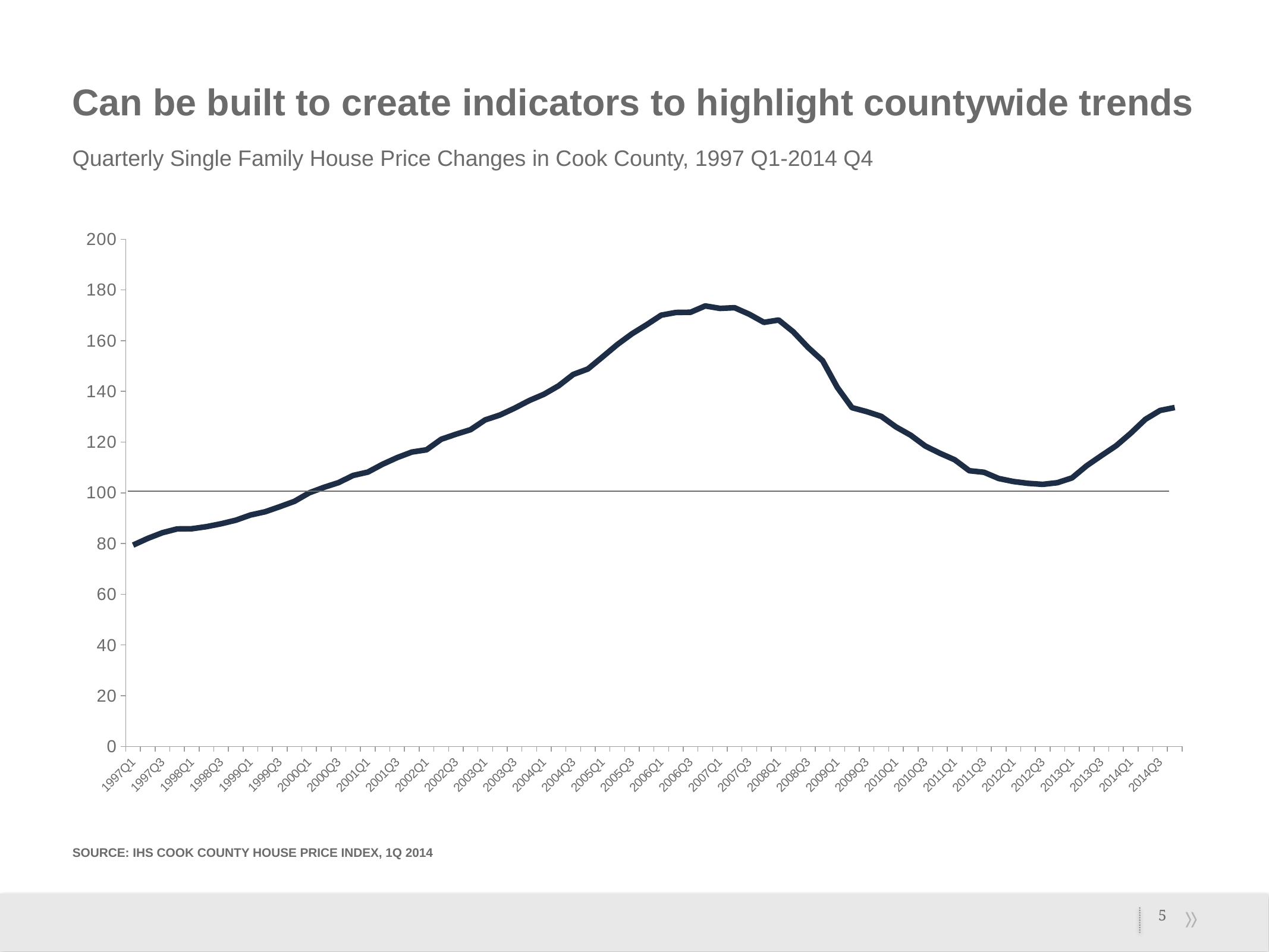
What is the title of the chart? Quarterly Single Family House Price Changes in Cook County, 1997 Q1-2014 Q4 Does the index rise or fall between 2007Q1 and 2012Q3? Fall Is the value for 2007Q1 greater or less than 160? greater Is the value for 2014Q3 greater or less than 120? greater At what value is the horizontal reference line drawn across the chart? 100 Is the value for 2009Q3 greater or less than 140? less Which quarter has the lowest value on the chart? 1997Q1 What kind of chart is shown on the slide? Line chart Which is larger, the value for 2007Q1 or the value for 2012Q3? 2007Q1